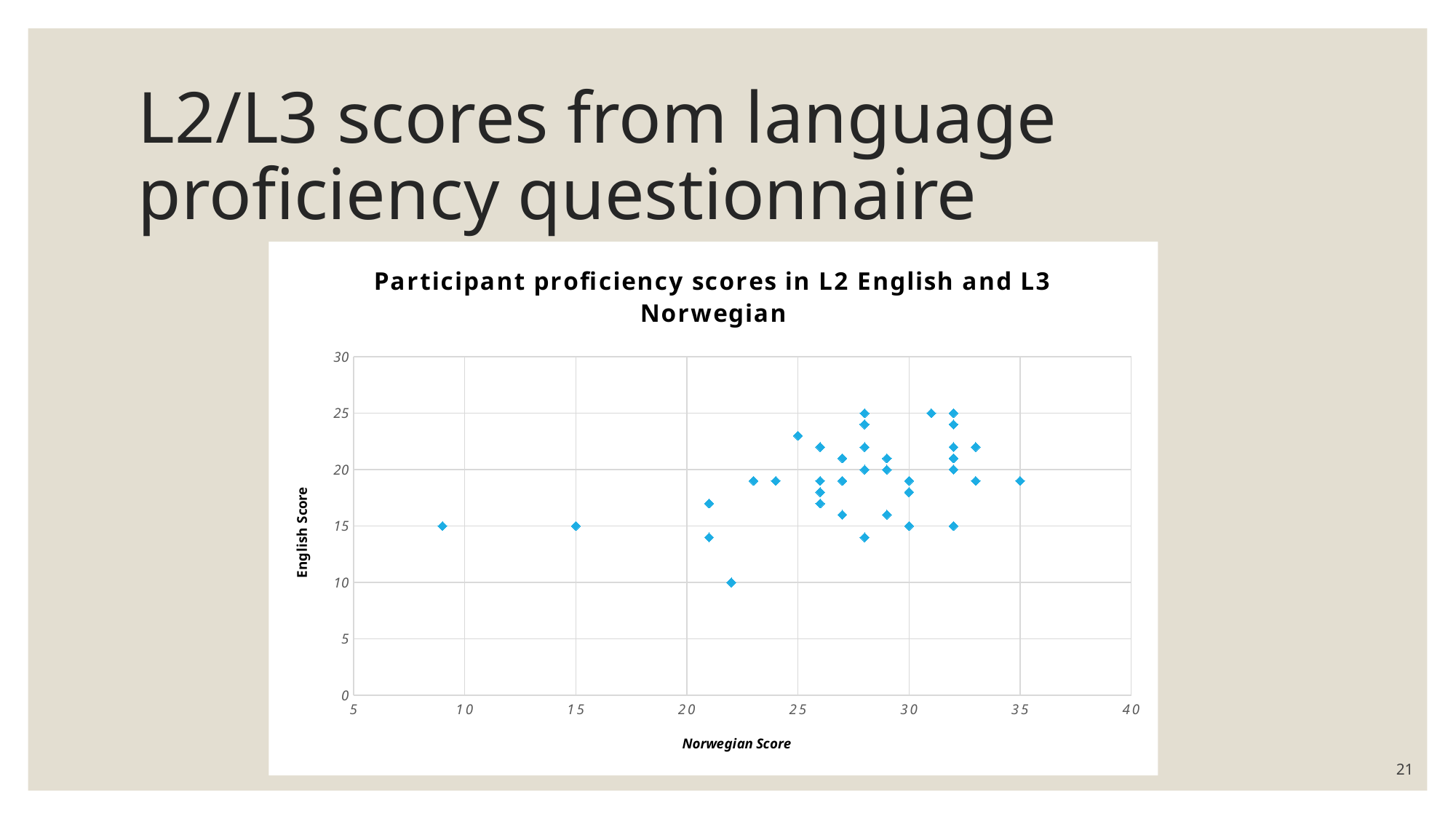
What kind of chart is shown on the slide? scatter plot Is the Norwegian score of the point with the lowest English score greater or less than 20? greater What is the English score of the participant with the lowest Norwegian score? 15 What is the highest English score plotted on the chart? 25 What is the English score of the point plotted at a Norwegian score of 15? 15 Is the English score of the rightmost point (Norwegian score 35) greater or less than 25? less Is the Norwegian score of the leftmost point greater or less than 10? less What is the lowest English score plotted on the chart? 10 What is the Norwegian score of the rightmost point on the chart? 35 Do English scores generally rise or fall as Norwegian scores increase along the x axis? rise What is the title of the chart? Participant proficiency scores in L2 English and L3 Norwegian What is the label of the horizontal axis of the chart? Norwegian Score